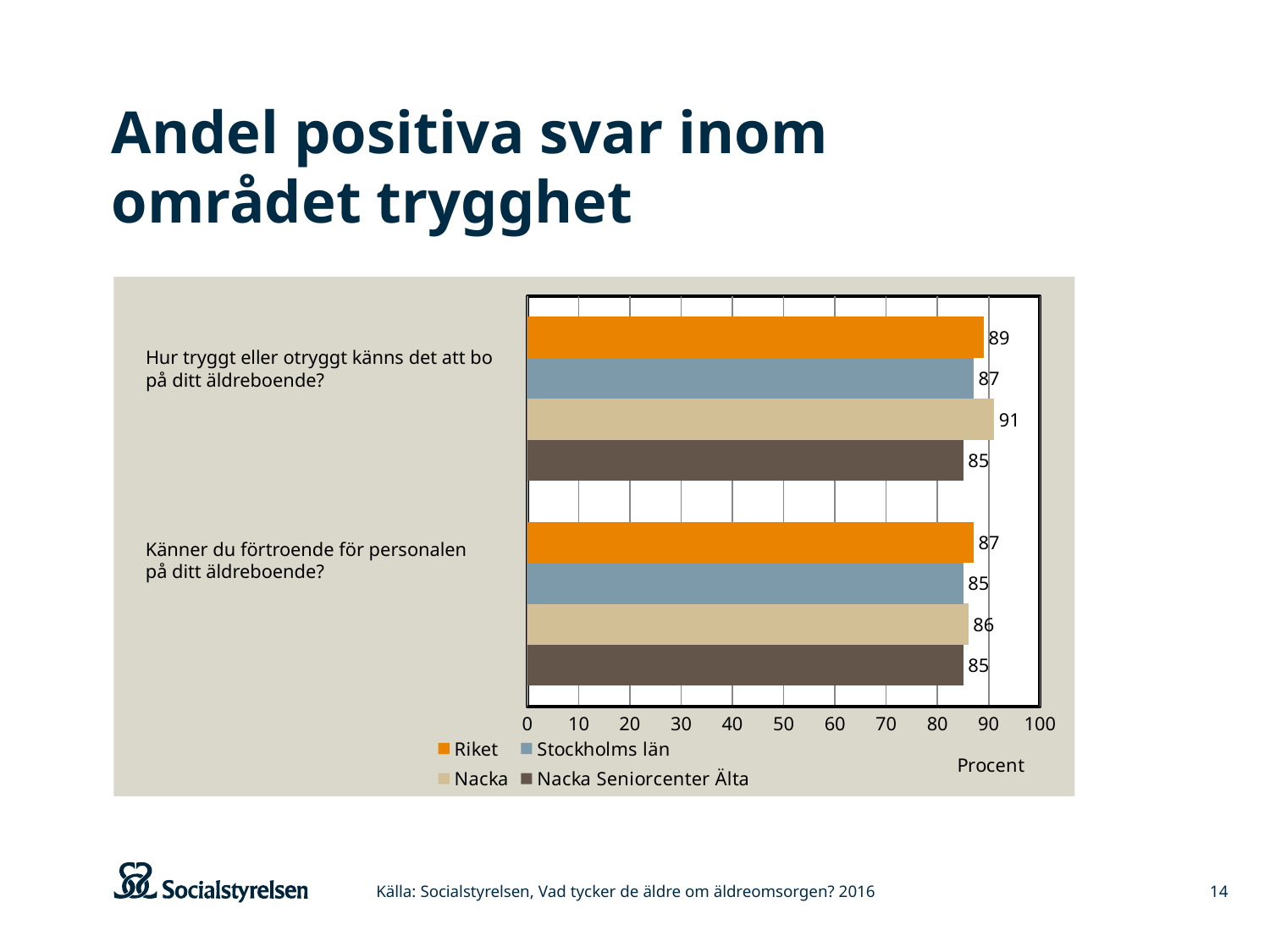
What is the value for Riket for the question "Känner du förtroende för personalen på ditt äldreboende?"? 87 Which series has the highest value for the question "Hur tryggt eller otryggt känns det att bo på ditt äldreboende?"? Nacka What is the value for Nacka Seniorcenter Älta for the question "Hur tryggt eller otryggt känns det att bo på ditt äldreboende?"? 85 How many series does the legend list? 4 What is the difference between the Nacka value and the Nacka Seniorcenter Älta value for the question "Hur tryggt eller otryggt känns det att bo på ditt äldreboende?"? 6 What is the difference between the Riket value and the Stockholms län value for the question "Känner du förtroende för personalen på ditt äldreboende?"? 2 Which is larger for the question "Hur tryggt eller otryggt känns det att bo på ditt äldreboende?": the Riket value or the Stockholms län value? Riket What kind of chart is shown on the slide? Bar chart What is the label of the x axis? Procent Which series has the lowest value for the question "Hur tryggt eller otryggt känns det att bo på ditt äldreboende?"? Nacka Seniorcenter Älta What is the value for Nacka for the question "Hur tryggt eller otryggt känns det att bo på ditt äldreboende?"? 91 What is the value for Stockholms län for the question "Känner du förtroende för personalen på ditt äldreboende?"? 85